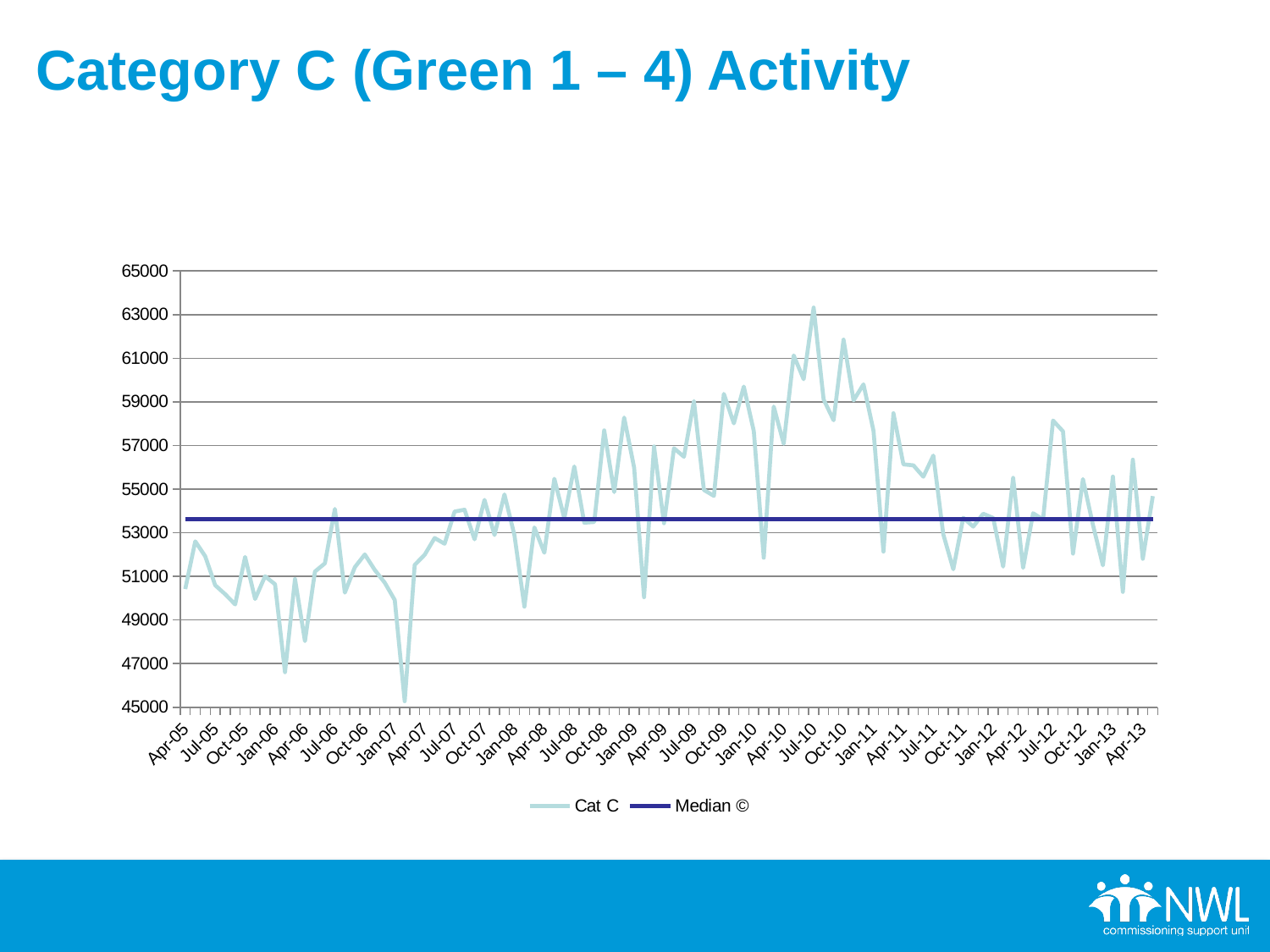
What is the title of the slide containing the chart? Category C (Green 1 – 4) Activity Around which x-axis label does the Cat C line reach its lowest point? Jan-07 Does the Cat C line generally rise or fall from Apr-05 to Jul-10? rise What kind of chart is shown on the slide? line chart Is the peak value of Cat C near Jul-10 greater or less than 61000? greater Around which x-axis label does the Cat C line reach its highest point? Jul-10 Which is larger, the Cat C value near Jul-10 or the Cat C value near Apr-06? Jul-10 Is the Median line greater or less than 55000? less Is the Median line greater or less than 53000? greater What are the two series named in the legend? Cat C and Median © How many series does the legend list? 2